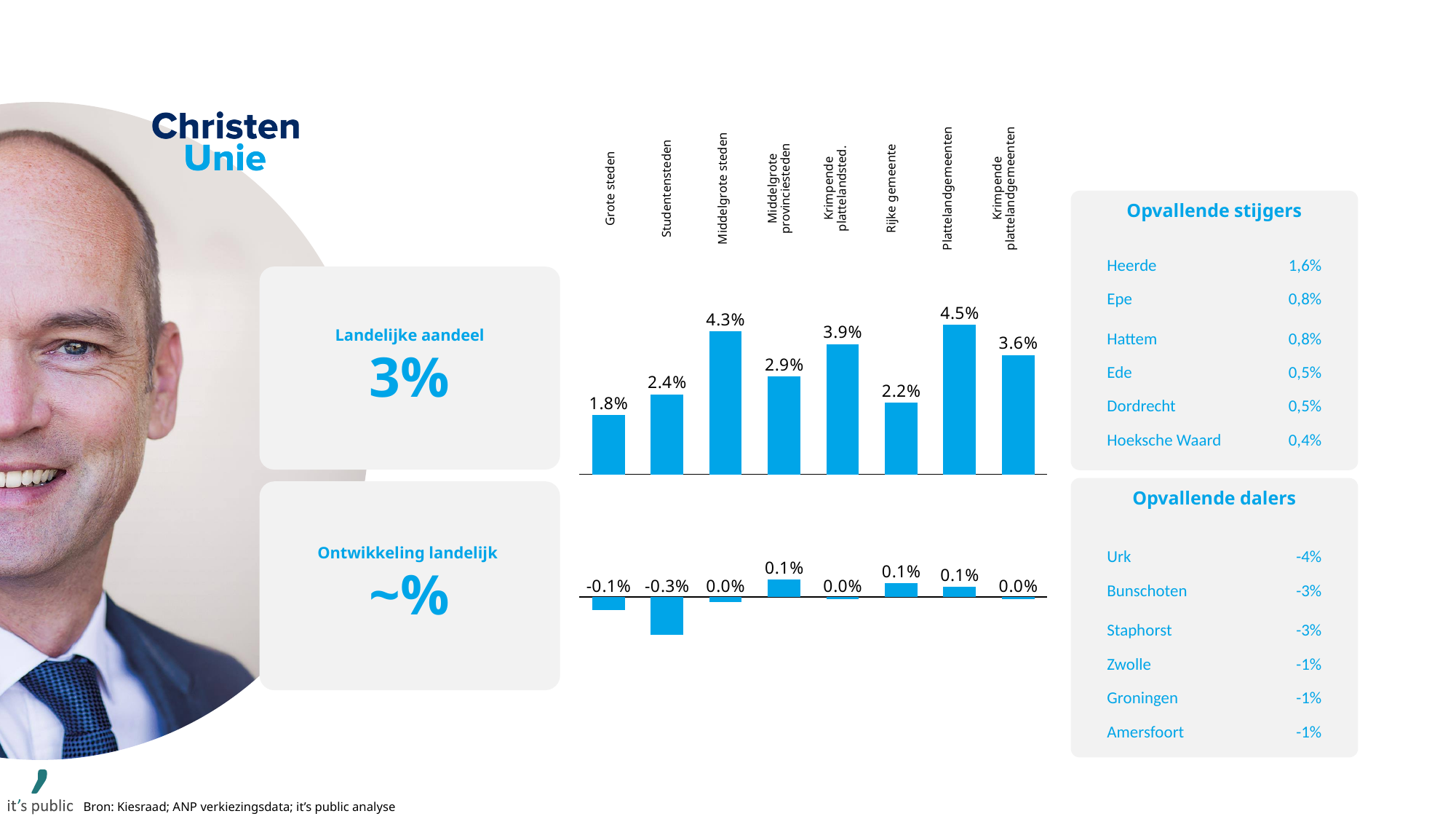
In the upper chart, what is the value for Grote steden? 1.8% In the upper chart, what is the value for Middelgrote steden? 4.3% In the upper chart, which is larger: Krimpende plattelandsted. or Krimpende plattelandgemeenten? Krimpende plattelandsted. In the lower chart, what is the value for Studentensteden? -0.3% In the lower chart, which category has the lowest value? Studentensteden In the upper chart, which category has the lowest value? Grote steden In the lower chart, what is the value for Middelgrote provinciesteden? 0.1% How many categories are shown in the upper chart? 8 In the upper chart, what is the difference between Plattelandgemeenten and Studentensteden? 2.1% In the lower chart, which is larger: Grote steden or Rijke gemeente? Rijke gemeente In the upper chart, which category has the highest value? Plattelandgemeenten What kind of chart is the lower chart? Bar chart